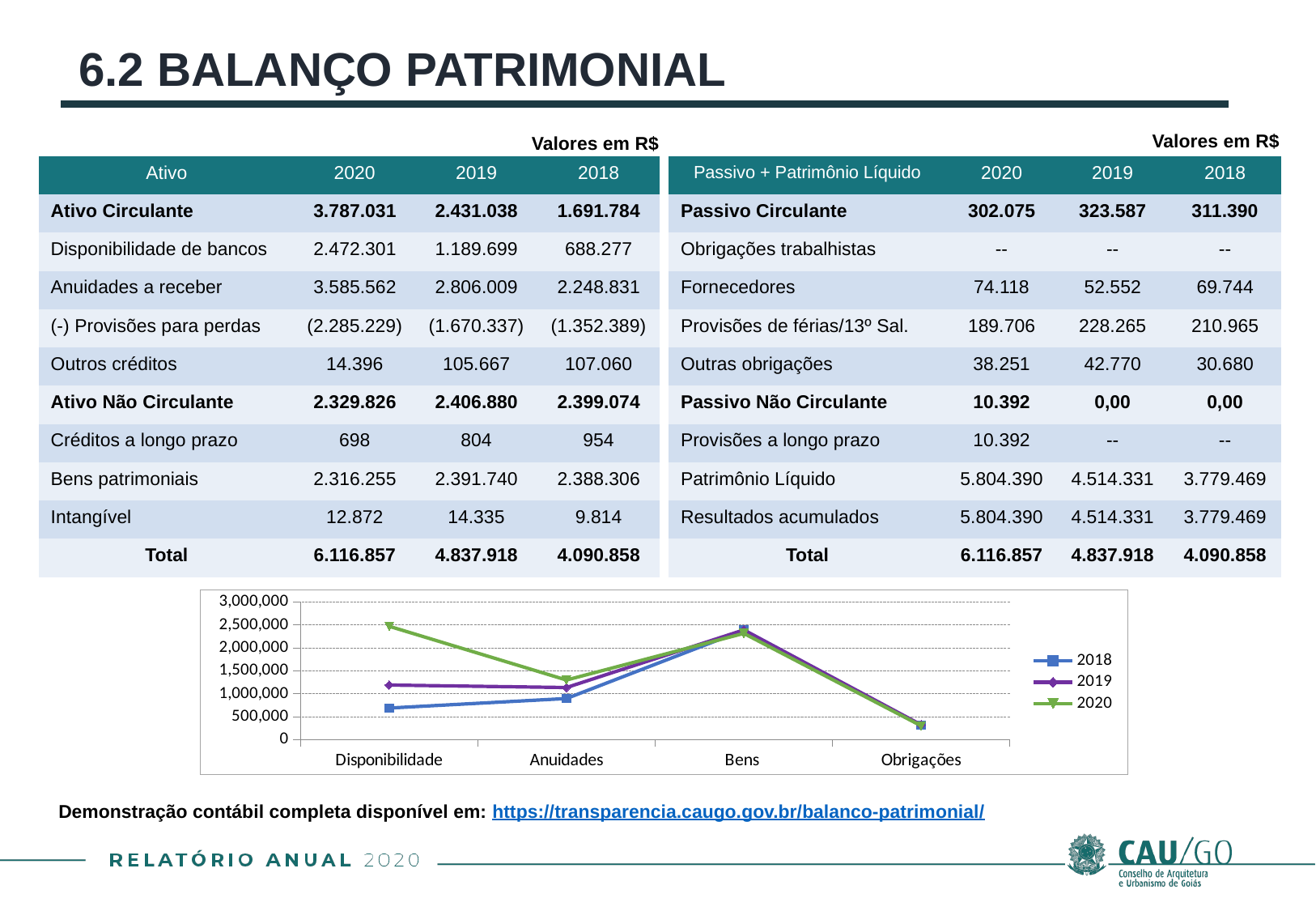
Does the 2020 series rise or fall from Disponibilidade to Anuidades? fall How many categories are shown on the x axis of the chart? 4 Which series has the lowest value for Disponibilidade? 2018 What are the entries listed in the chart legend? 2018, 2019, 2020 For the 2018 series, which category has the highest value? Bens Is the 2018 value for Disponibilidade greater or less than 1,000,000? less What kind of chart is shown on the slide? line chart Which series has the highest value for Disponibilidade? 2020 Is the 2020 value for Disponibilidade greater or less than 2,000,000? greater How many series does the chart legend list? 3 Is the 2019 value for Obrigações greater or less than 500,000? less For Anuidades, which is larger: the 2020 value or the 2018 value? 2020